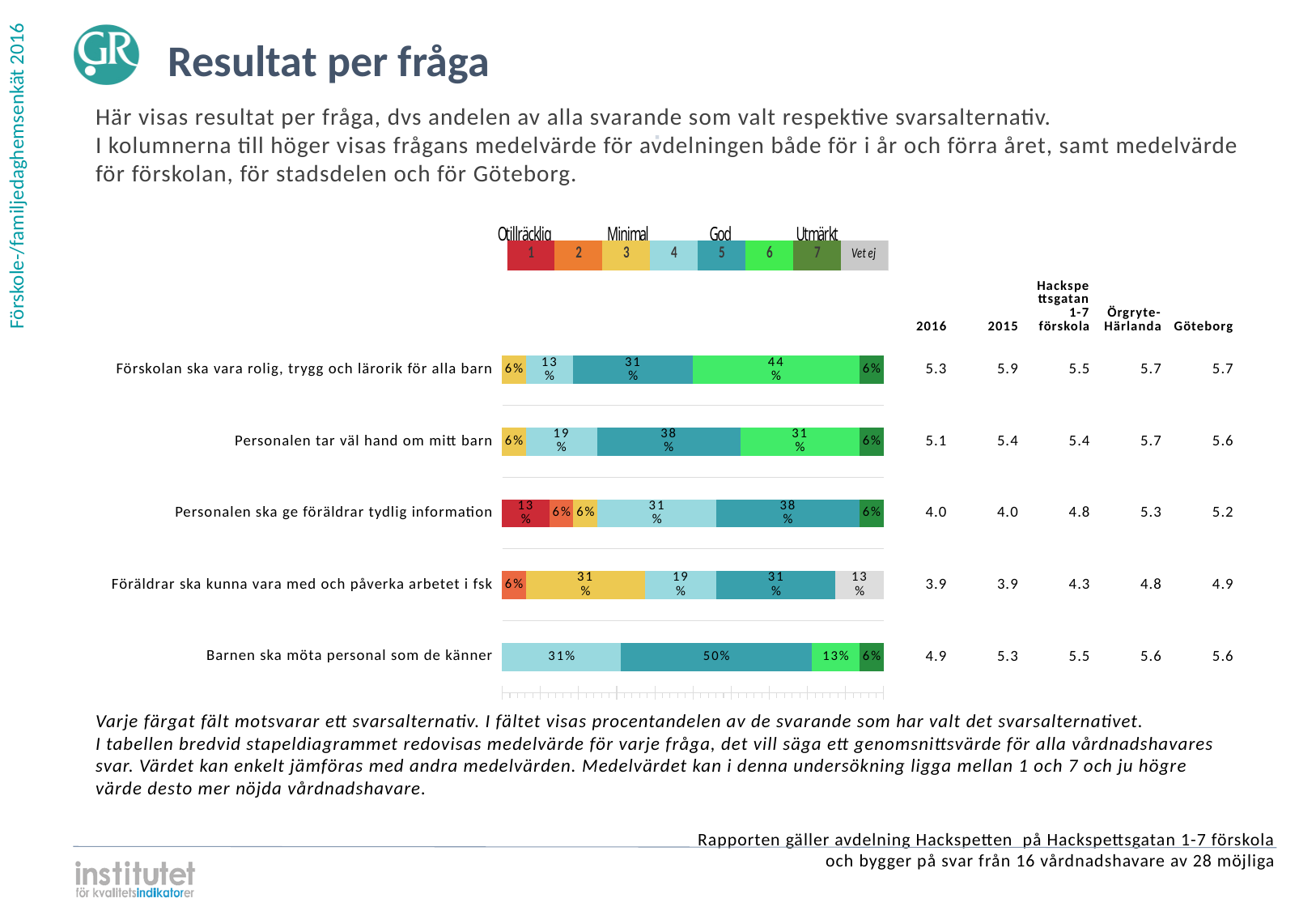
Which is larger for 'Barnen ska möta personal som de känner': the share for answer 4 or the share for answer 6? Answer 4 What label does the legend give to answer alternative 7? Utmärkt What percentage chose answer 5 (teal) for 'Barnen ska möta personal som de känner'? 50% What percentage chose 'Vet ej' for 'Föräldrar ska kunna vara med och påverka arbetet i fsk'? 13% What percentage of respondents chose answer 6 (bright green) for 'Förskolan ska vara rolig, trygg och lärorik för alla barn'? 44% What is the 2016 mean value shown for 'Föräldrar ska kunna vara med och påverka arbetet i fsk'? 3.9 What kind of chart is shown on the slide? Stacked bar chart How many questions (categories) are plotted in the bar chart? 5 Which answer alternative has the largest share for 'Personalen tar väl hand om mitt barn'? 5 What percentage chose answer 1 (red) for 'Personalen ska ge föräldrar tydlig information'? 13% How many entries does the legend above the chart list? 8 What is the difference between the share for answer 5 and the share for answer 6 in 'Personalen tar väl hand om mitt barn'? 7%